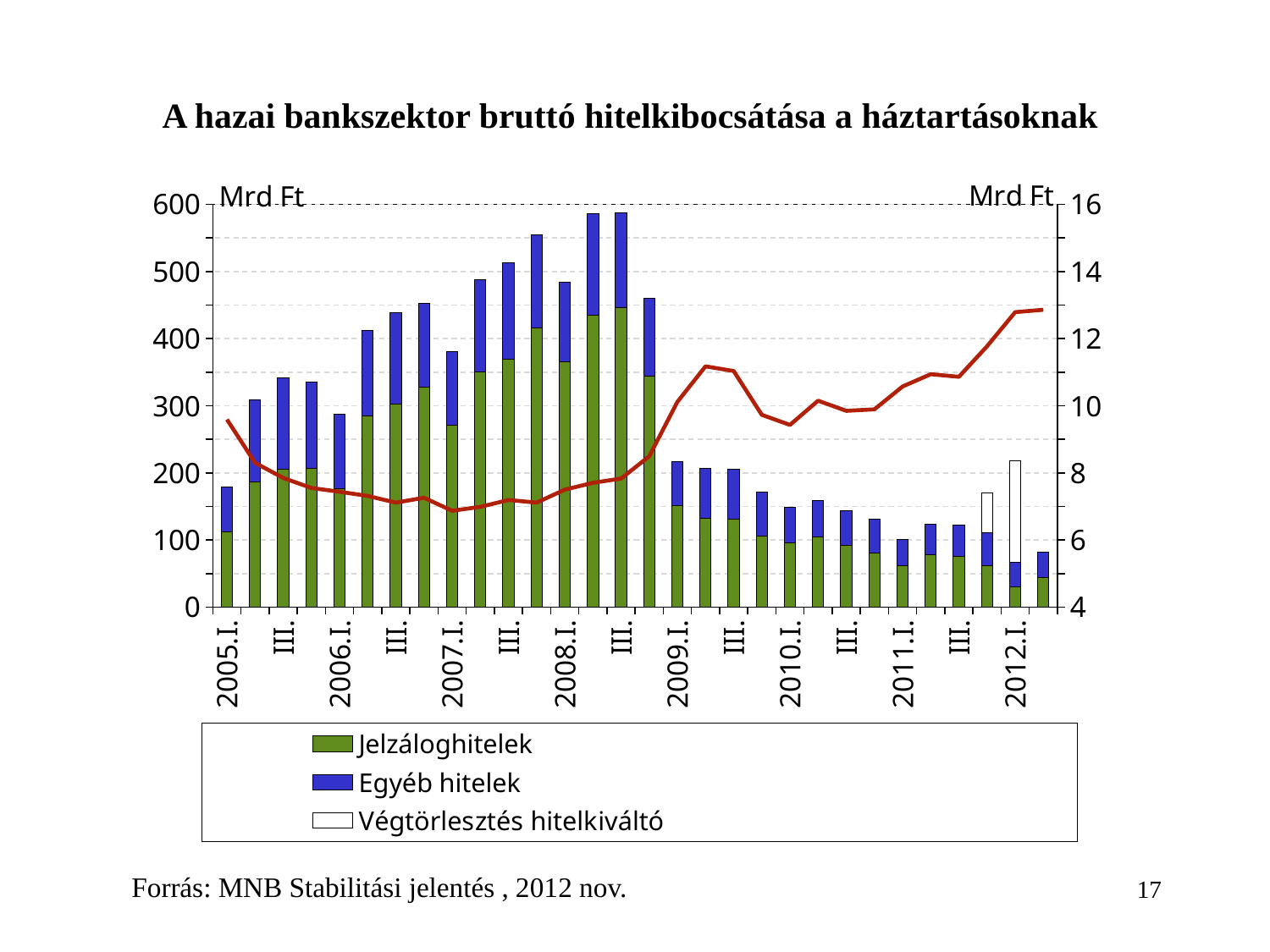
Is the total bar for 2005.I. greater or less than 200? less How many series does the legend list? 3 Which has the larger total bar, 2008.I. or 2009.I.? 2008.I. Is the total bar for 2010.I. greater or less than 200? less What is the title of the chart? A hazai bankszektor bruttó hitelkibocsátása a háztartásoknak Is the total bar for 2009.I. greater or less than 300? less Which has the larger total bar, 2005.I. or 2007.I.? 2007.I. Do the total bars generally rise or fall from 2009.I. to 2011.III.? fall What kind of chart is shown on the slide? bar chart (stacked bars with a line) What unit is shown on the left vertical axis? Mrd Ft